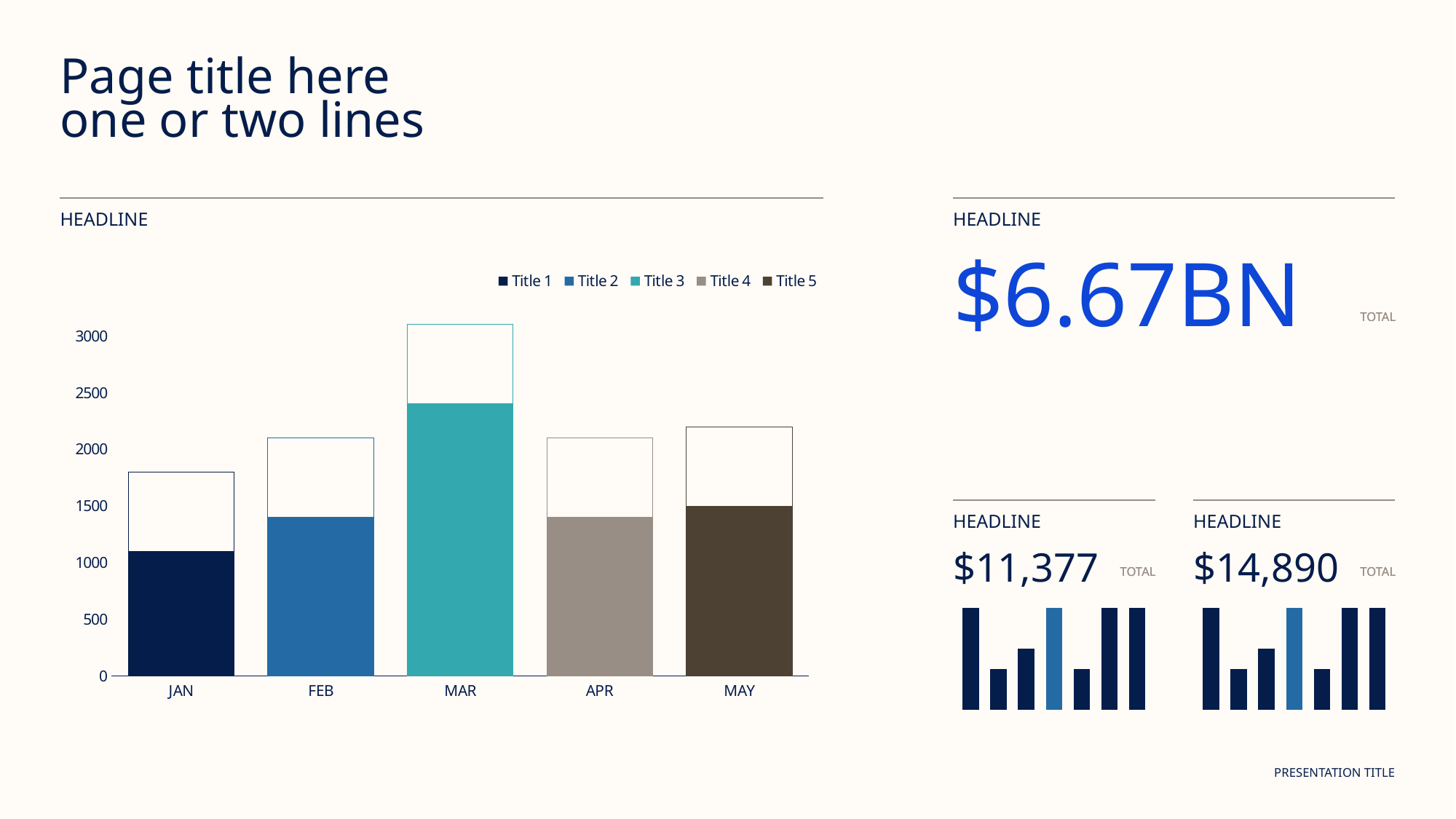
In the bar chart on the left, how many months are shown on the x axis? 5 In the bar chart on the left, which month has the tallest bar? MAR In the bar chart on the left, which month has the shortest bar? JAN In the bar chart on the left, is the outlined bar for JAN greater or less than 2000? less How many series does the legend of the bar chart on the left list? 5 In the bar chart on the left, which bar is taller, MAR or FEB? MAR In the bar chart on the left, is the filled bar for APR greater or less than 1000? greater In the bar chart on the left, do the bars rise or fall from JAN to MAR? rise In the bar chart on the left, what is the first entry in the legend? Title 1 In the bar chart on the left, is the filled bar for JAN greater or less than 1500? less What kind of chart is shown on the left of the slide? bar chart